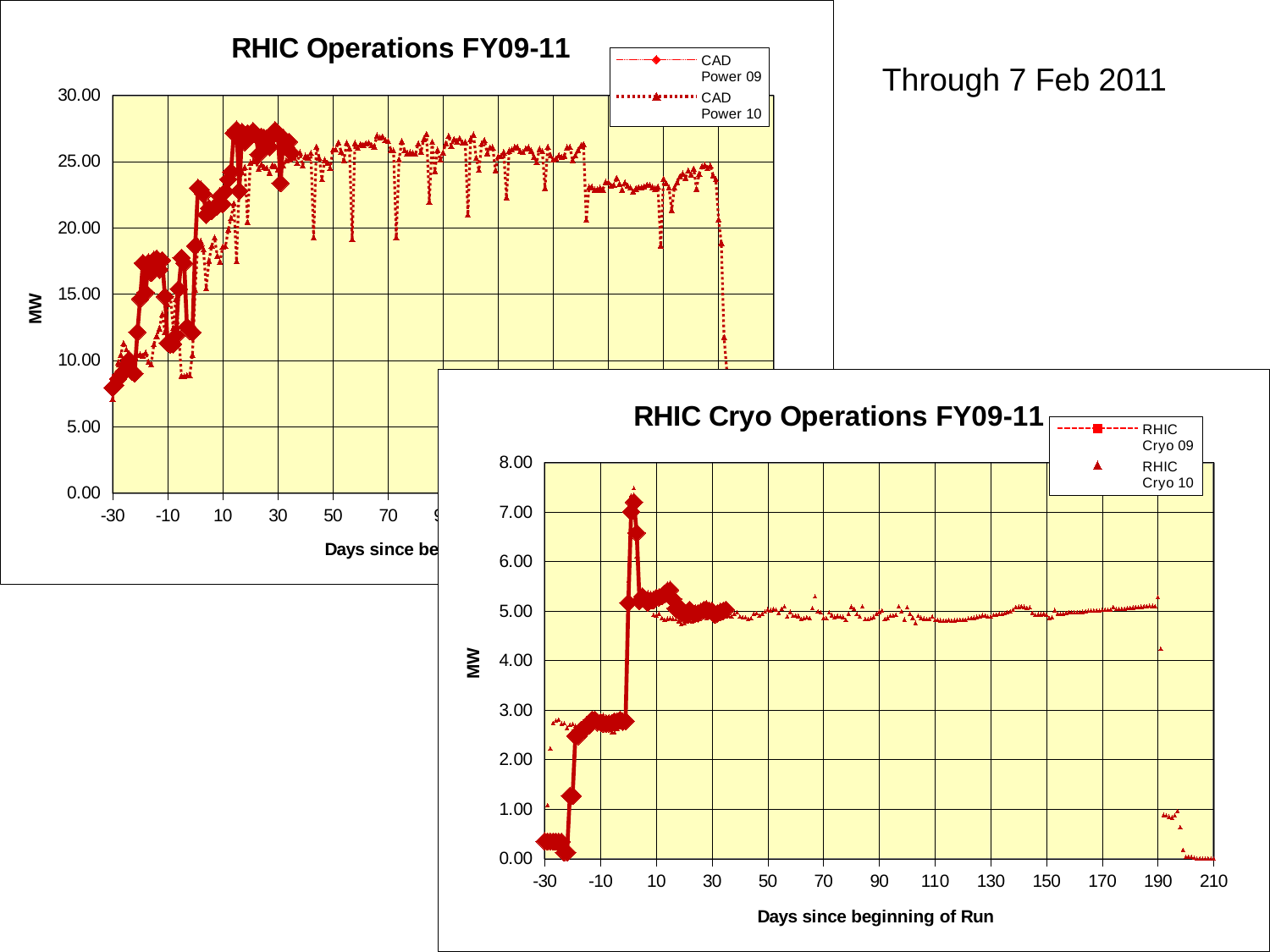
In the "RHIC Operations FY09-11" chart, is the CAD Power 09 value at day -30 greater or less than 10.00? less What are the legend entries of the "RHIC Cryo Operations FY09-11" chart? RHIC Cryo 09, RHIC Cryo 10 In the "RHIC Operations FY09-11" chart, is the CAD Power 10 value at day 50 greater or less than 20.00? greater How many series does the legend of the "RHIC Operations FY09-11" chart list? 2 What kind of chart is the "RHIC Operations FY09-11" chart? line chart What is the x-axis label of the "RHIC Cryo Operations FY09-11" chart? Days since beginning of Run In the "RHIC Cryo Operations FY09-11" chart, does the RHIC Cryo 09 series rise or fall between day -30 and day 0? rise In the "RHIC Operations FY09-11" chart, does the CAD Power 09 series rise or fall between day -30 and day 30? rise How many series does the legend of the "RHIC Cryo Operations FY09-11" chart list? 2 In the "RHIC Cryo Operations FY09-11" chart, is the RHIC Cryo 10 value at day 200 greater or less than 2.00? less